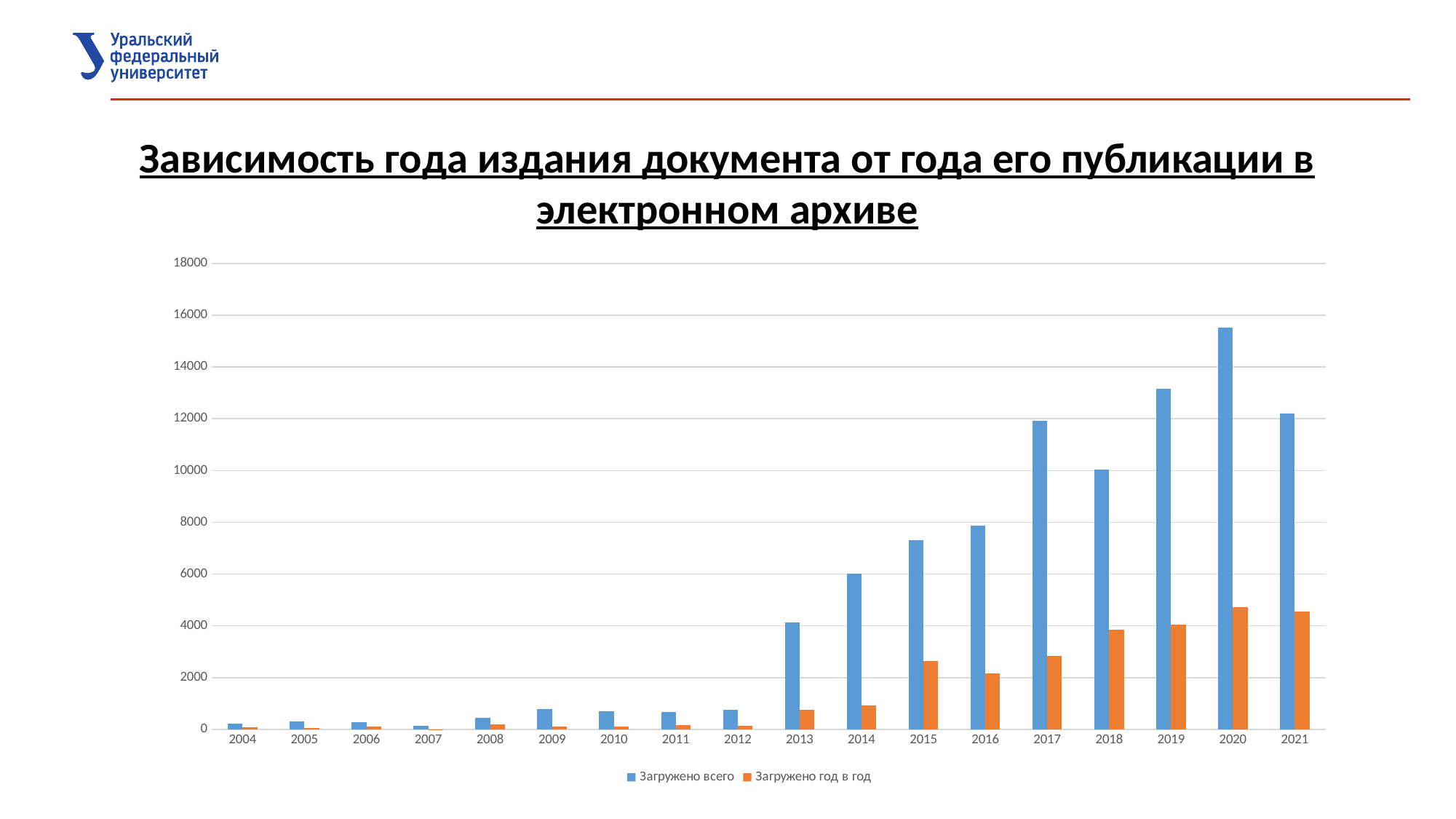
Is the value for Загружено всего in 2017 greater or less than 10000? greater Which is larger for Загружено всего: 2019 or 2021? 2019 Which year has the highest value for Загружено всего? 2020 How many series does the legend list? 2 Is the value for Загружено год в год in 2021 greater or less than 4000? greater How many years are shown on the x axis? 18 Is the value for Загружено год в год in 2013 greater or less than 1000? less Does the value for Загружено всего rise or fall from 2013 to 2020? rise What kind of chart is shown on the slide? bar chart Which is larger for Загружено год в год: 2016 or 2017? 2017